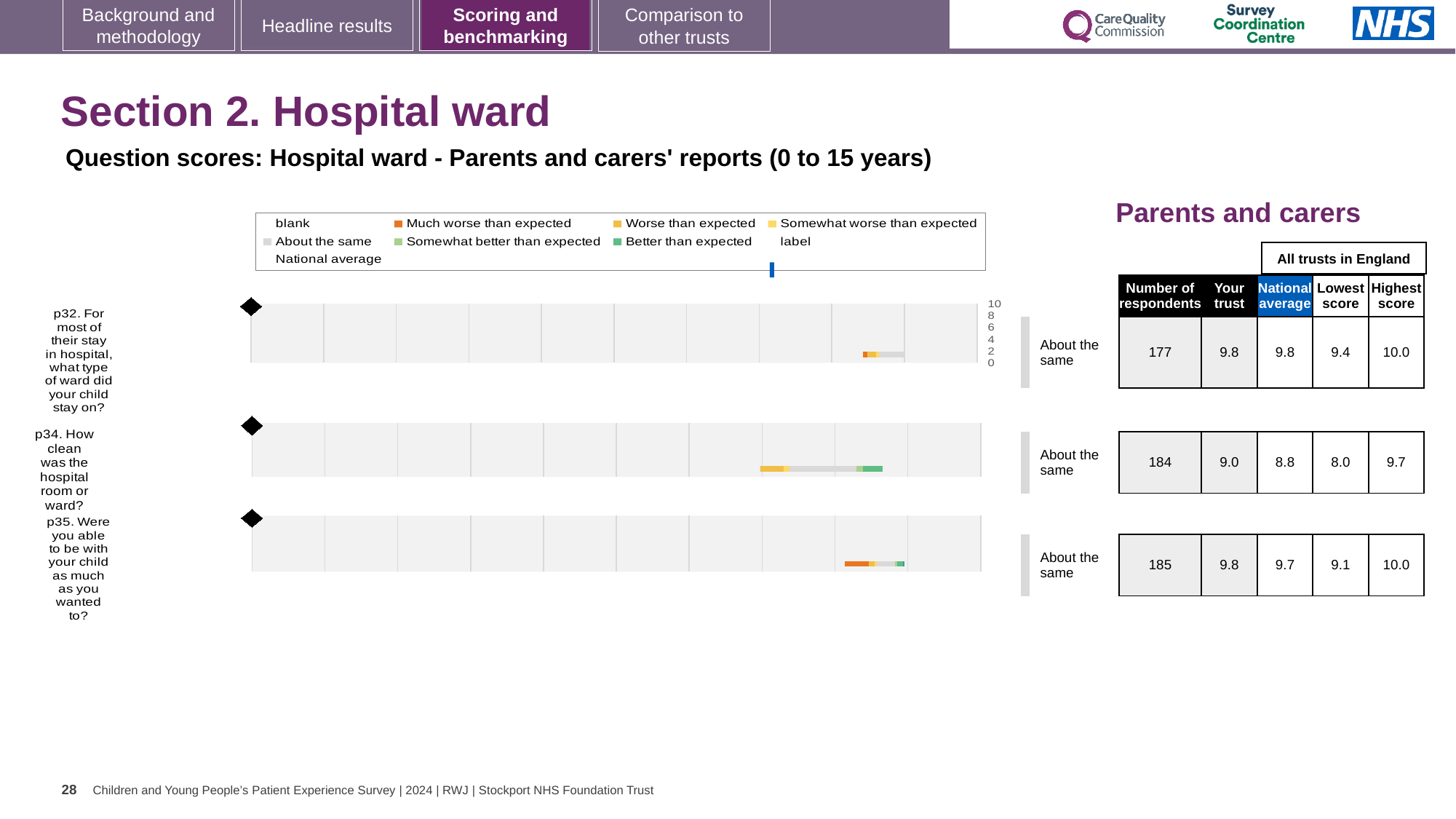
What is the difference between the highest score and the lowest score for question p34? 1.7 What benchmark category is shown next to each of the three question charts? About the same How many respondents are listed for question p34 (How clean was the hospital room or ward?)? 184 What is the national average score for question p35 (were you able to be with your child as much as you wanted to)? 9.7 Which question has the lowest 'Your trust' score on this slide? p34 What is the lowest score among all trusts in England for question p34? 8.0 For question p34, which is larger: the 'Your trust' score or the national average? Your trust What kind of chart is used to show the question scores on this slide? Bar chart What is the 'Your trust' score for question p32 (what type of ward did your child stay on)? 9.8 Which question has the highest number of respondents? p35 How many questions are charted on this slide? 3 What is the highest score among all trusts in England for question p35? 10.0